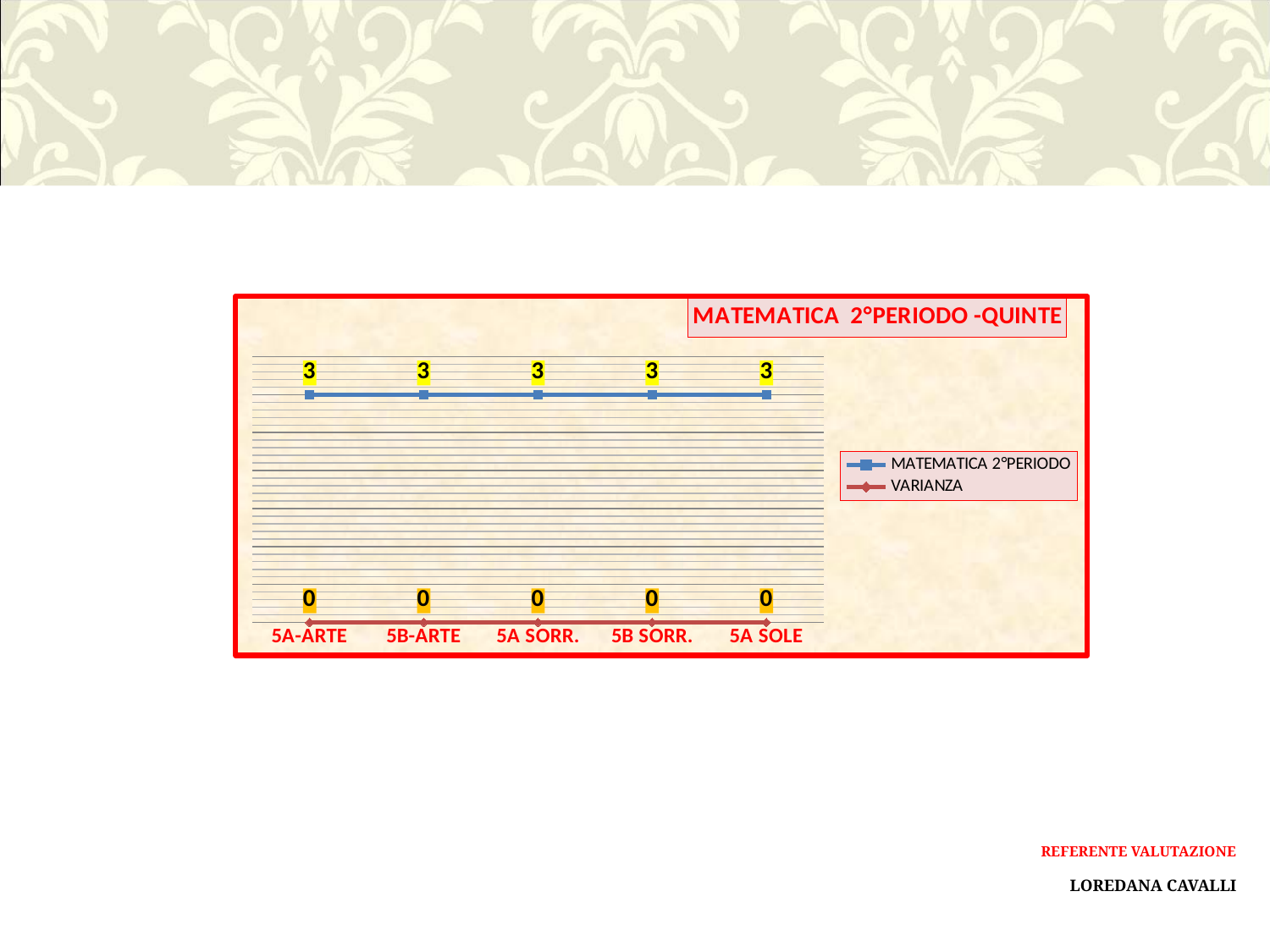
What is the MATEMATICA 2°PERIODO value for 5A SOLE? 3 How many series does the legend list? 2 What is the VARIANZA value for 5B SORR.? 0 Do the MATEMATICA 2°PERIODO values rise, fall, or stay flat across the categories? stay flat Which is larger for 5B-ARTE: the MATEMATICA 2°PERIODO value or the VARIANZA value? MATEMATICA 2°PERIODO What is the title of the chart? MATEMATICA 2°PERIODO -QUINTE How many categories are shown on the x axis? 5 What type of chart is shown on the slide? line chart What is the VARIANZA value for 5A-ARTE? 0 What is the difference between the MATEMATICA 2°PERIODO value and the VARIANZA value for 5A SORR.? 3 Which series is drawn in blue in the legend? MATEMATICA 2°PERIODO What is the MATEMATICA 2°PERIODO value for 5A-ARTE? 3